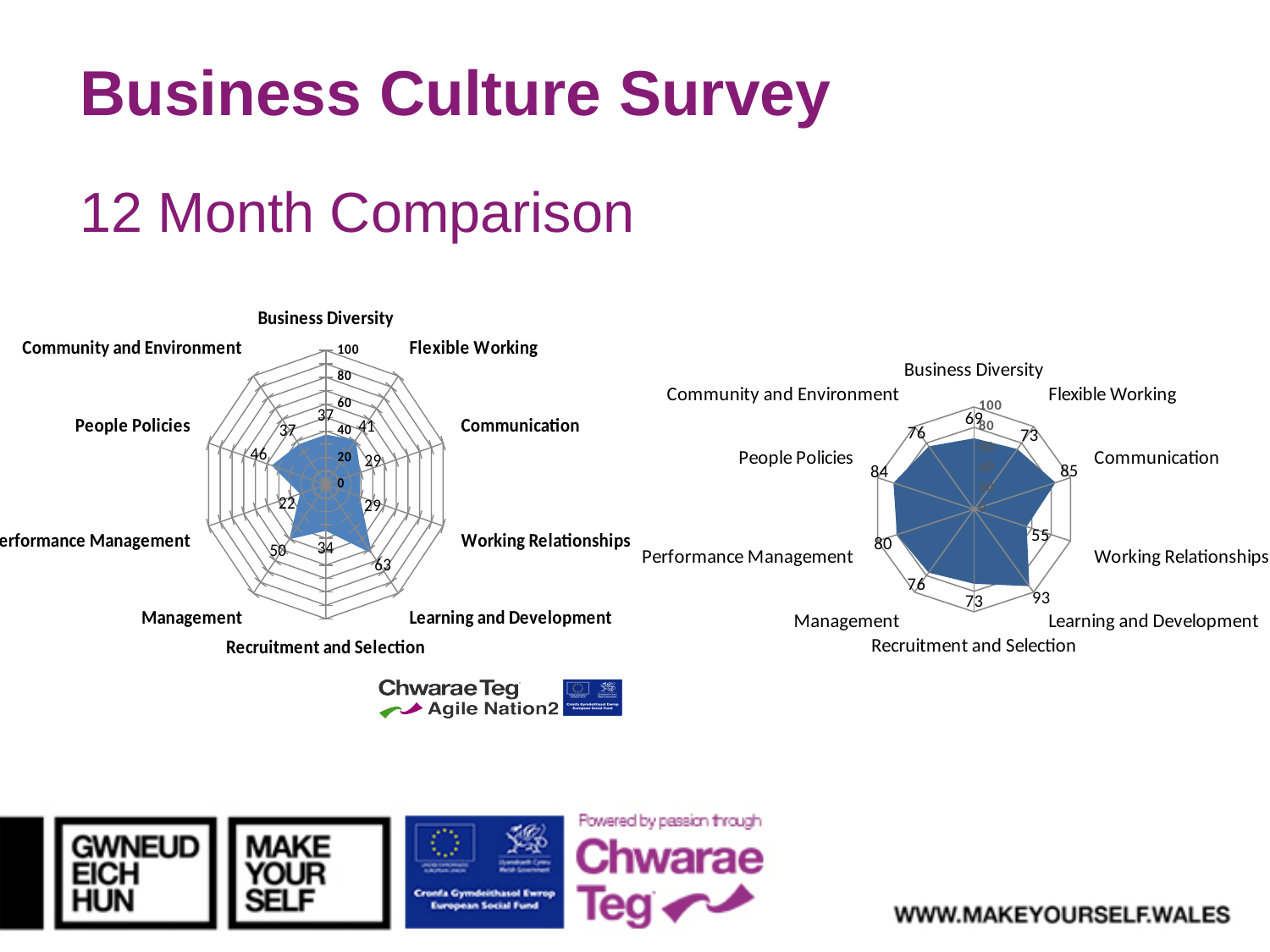
On the left radar chart, what is the value for Learning and Development? 63 On the left radar chart, what is the value for Performance Management? 22 What is the difference between the Learning and Development values on the right chart and the left chart? 30 On the right radar chart, what is the value for Working Relationships? 55 On the right radar chart, which category has the highest value? Learning and Development How many categories does the left radar chart have? 10 What kind of chart is shown on the right of the slide? Radar chart On the left radar chart, which is larger: Management or People Policies? Management On the right radar chart, what is the difference between People Policies and Business Diversity? 15 On the left radar chart, which category has the lowest value? Performance Management On the right radar chart, what is the value for Communication? 85 On the right radar chart, which category has the lowest value? Working Relationships